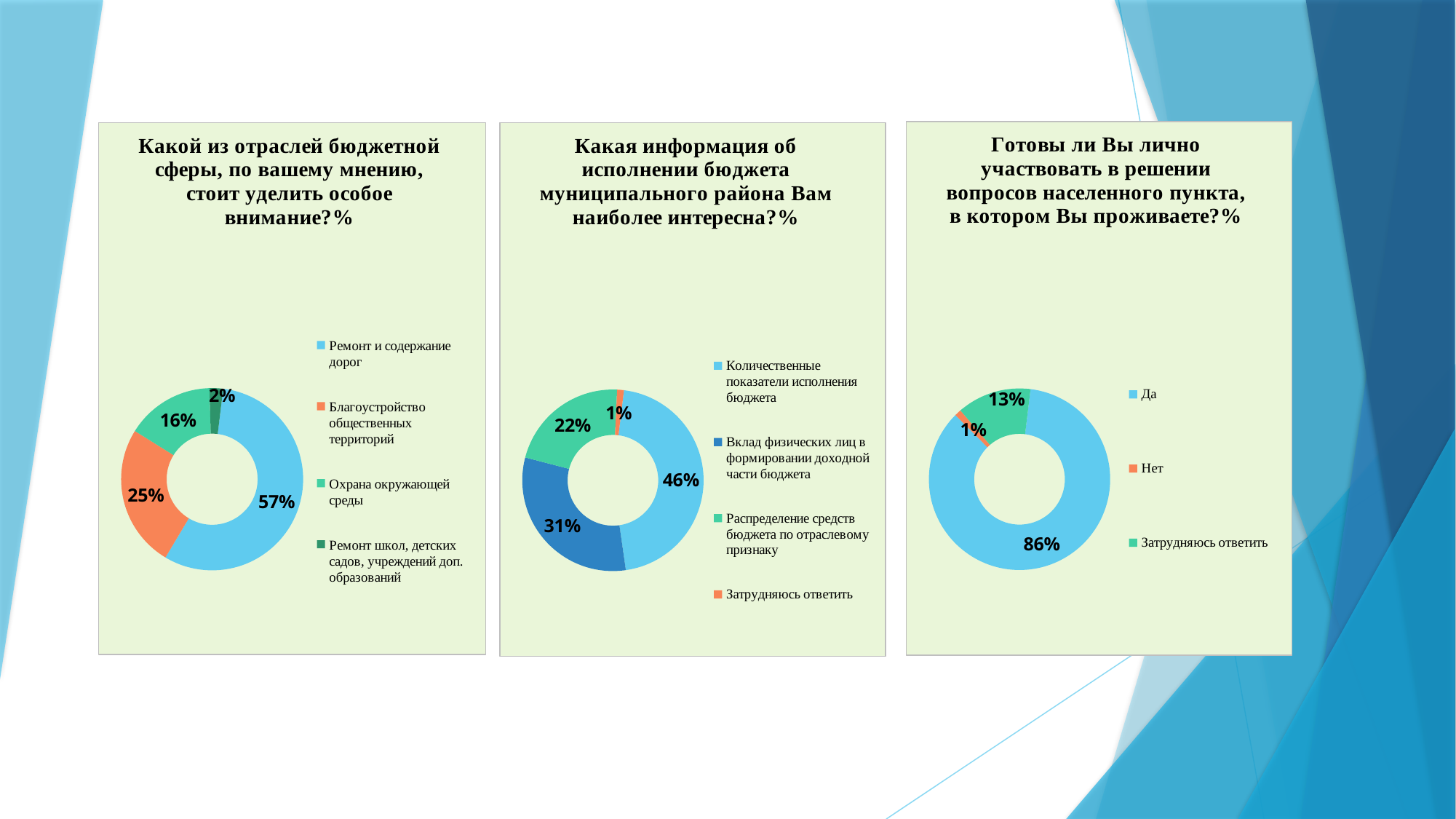
In the right chart, what share is shown for "Затрудняюсь ответить"? 13% In the left chart, what is the difference between the shares for "Благоустройство общественных территорий" and "Охрана окружающей среды"? 9% In the right chart, which category has the smallest share? Нет In the middle chart, what is the difference between the shares for "Количественные показатели исполнения бюджета" and "Распределение средств бюджета по отраслевому признаку"? 24% In the middle chart, which is larger: "Распределение средств бюджета по отраслевому признаку" or "Затрудняюсь ответить"? Распределение средств бюджета по отраслевому признаку How many categories does the legend of the left chart list? 4 In the middle chart, which category has the largest share? Количественные показатели исполнения бюджета In the left chart, which category has the smallest share? Ремонт школ, детских садов, учреждений доп. образований In the right chart ("Готовы ли Вы лично участвовать..."), what share answered "Да"? 86% In the left chart ("Какой из отраслей бюджетной сферы..."), what share is shown for "Ремонт и содержание дорог"? 57% What type of chart is used on this slide? Doughnut chart In the middle chart ("Какая информация об исполнении бюджета..."), what share is shown for "Вклад физических лиц в формировании доходной части бюджета"? 31%